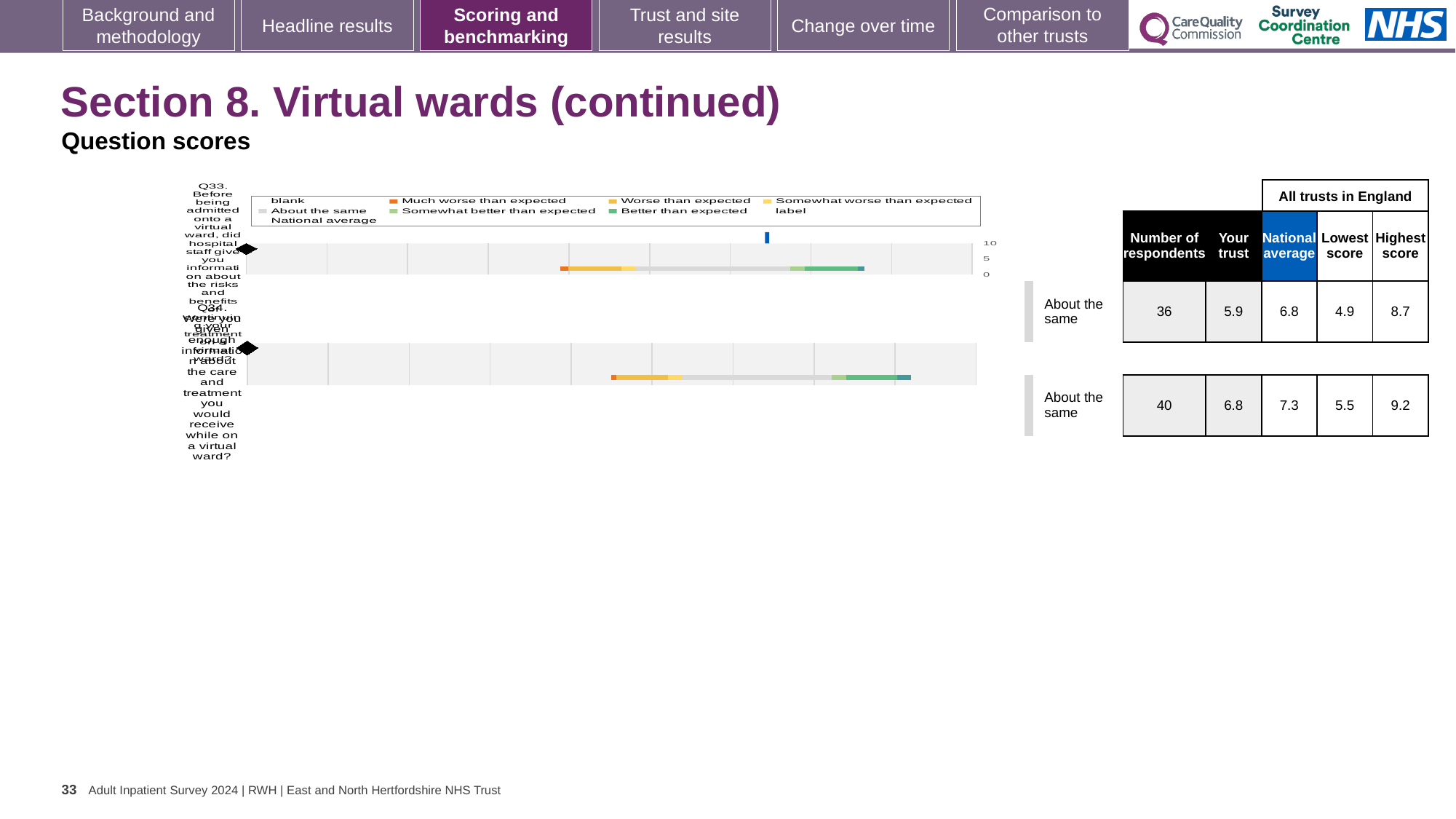
Which question has the higher 'Your trust' score, Q33 or Q34? Q34 In the table, what is the 'Your trust' score for Q34 (enough information about care and treatment on a virtual ward)? 6.8 In the table, what is the 'Your trust' score for Q33 (information about the risks and benefits of a virtual ward)? 5.9 What benchmark category is shown next to both Q33 and Q34? About the same In the table, what is the national average for Q34? 7.3 In the table, what is the national average for Q33? 6.8 In the table, what is the lowest score among all trusts in England for Q34? 5.5 In the table, how many respondents answered Q34? 40 What is the difference between the national average and the trust's score for Q33? 0.9 How many questions (bars) are plotted in the chart? 2 What kind of chart is shown on the slide? bar chart In the table, what is the highest score among all trusts in England for Q33? 8.7